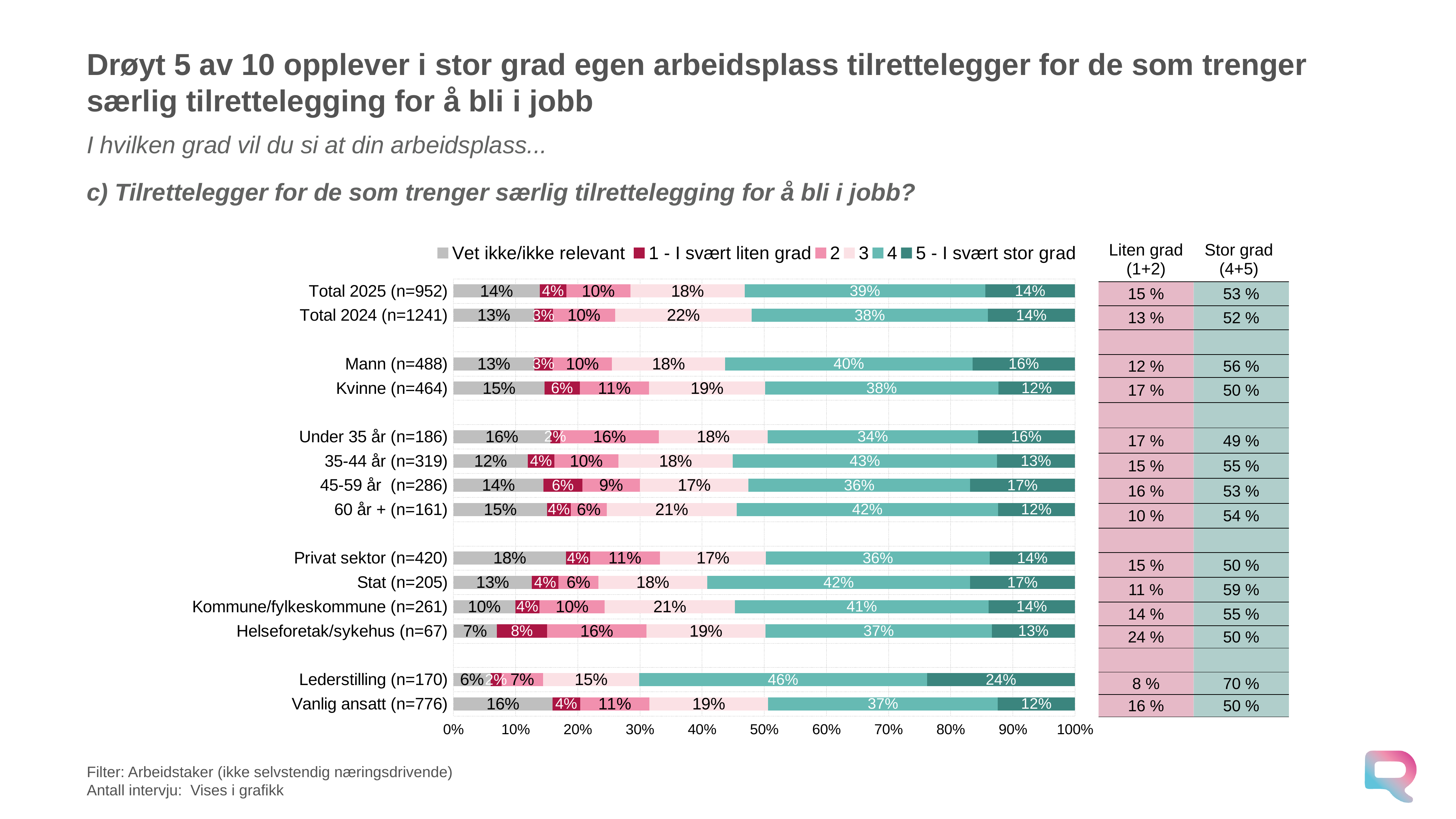
What is the first entry in the chart's legend? Vet ikke/ikke relevant Which has a larger value for the "4" series: Stat (n=205) or Privat sektor (n=420)? Stat (n=205) What kind of chart is shown on the slide? Stacked bar chart How many categories (bars) are shown in the chart? 14 What is the value of the "3" series for Total 2024 (n=1241)? 22% What is the value of the "5 - I svært stor grad" series for Lederstilling (n=170)? 24% What is the value of the "4" series for Total 2025 (n=952)? 39% What is the value of the "1 - I svært liten grad" series for Helseforetak/sykehus (n=67)? 8% How many series does the legend list? 6 Which category has the highest value for the "5 - I svært stor grad" series? Lederstilling (n=170) Which category has the lowest value for the "Vet ikke/ikke relevant" series? Lederstilling (n=170) What is the difference between the "4" series values for Lederstilling (n=170) and Vanlig ansatt (n=776)? 9 percentage points